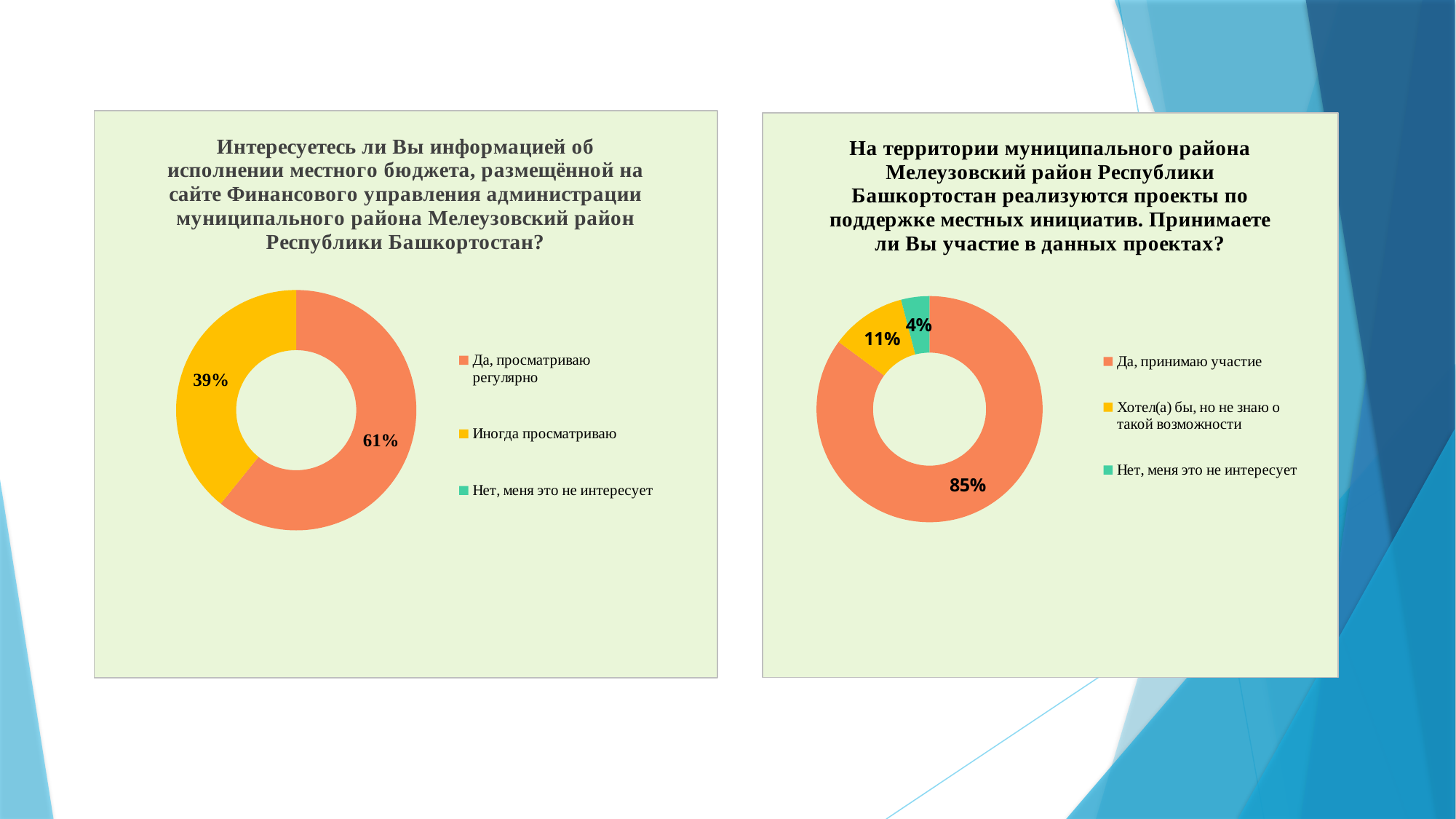
In the right chart, what is the difference between the shares for "Да, принимаю участие" and "Хотел(а) бы, но не знаю о такой возможности"? 74% What kind of chart is the left chart? Doughnut (pie) chart In the right chart, what share of respondents answered "Да, принимаю участие"? 85% In the left chart, what share of respondents answered "Да, просматриваю регулярно"? 61% In the right chart, which answer has the smallest share? Нет, меня это не интересует In the right chart, what share of respondents answered "Нет, меня это не интересует"? 4% How many entries does the legend of the left chart list? 3 In the left chart, what share of respondents answered "Иногда просматриваю"? 39% In the left chart, which answer has the largest share? Да, просматриваю регулярно In the right chart, what share of respondents answered "Хотел(а) бы, но не знаю о такой возможности"? 11% In the right chart, which colour represents "Нет, меня это не интересует"? Green (teal) In the left chart, what is the difference between the shares for "Да, просматриваю регулярно" and "Иногда просматриваю"? 22%